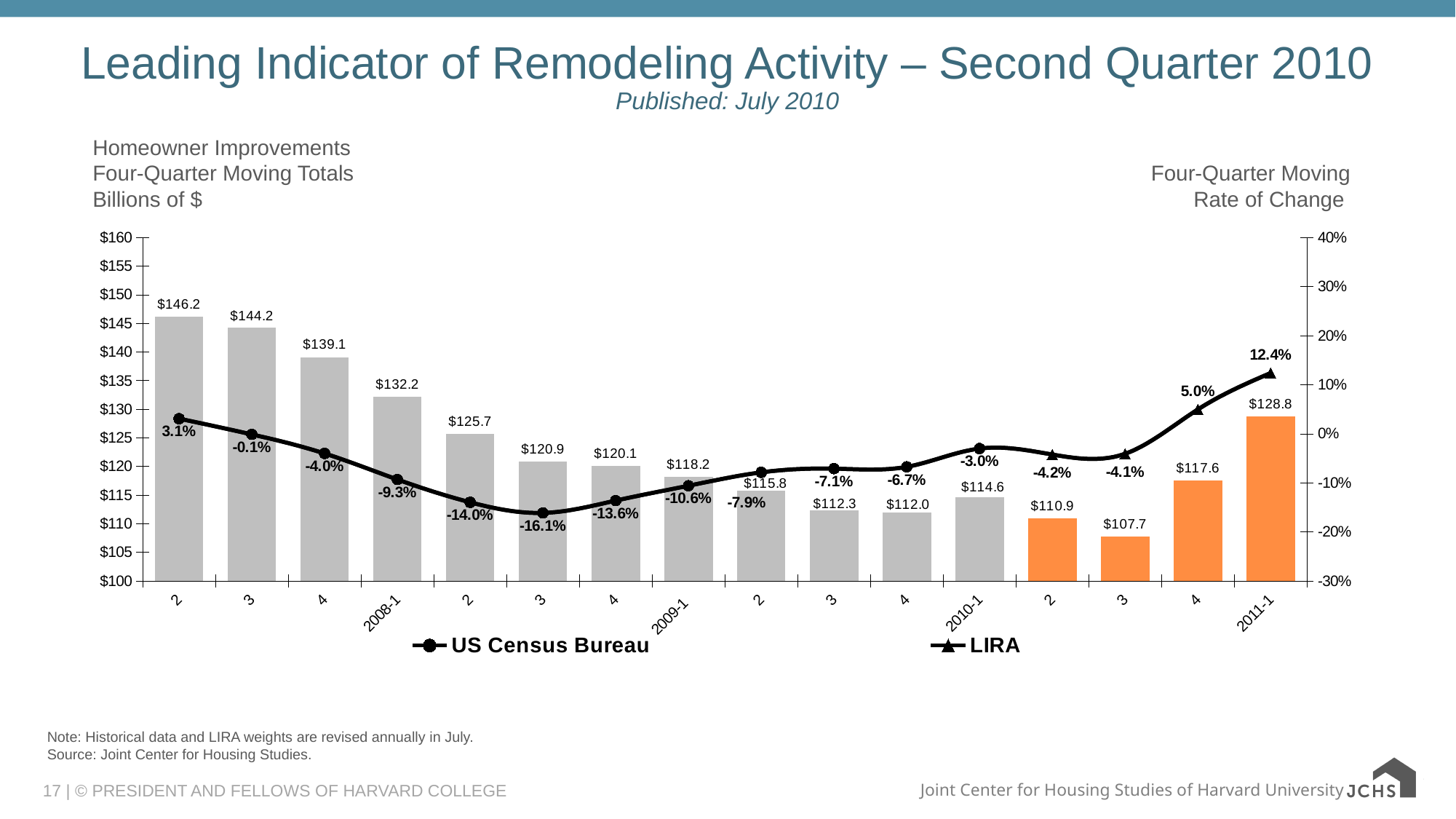
What kind of chart is this? Combined bar and line chart How many series does the legend list? 2 How much larger is the four-quarter moving total for 2011-1 than for 2010-1? $14.2 Which has the larger four-quarter moving total, 2009-1 or 2010-1? 2009-1 How many bars are plotted in the chart? 16 Do the four-quarter moving totals rise or fall from 2008-1 to 2009-1? Fall What is the four-quarter moving total for 2010-1? $114.6 What is the lowest rate of change value shown on the line? -16.1% What is the lowest four-quarter moving total shown by any bar? $107.7 What is the four-quarter moving rate of change shown for 2011-1? 12.4% What is the highest four-quarter moving total shown by any bar? $146.2 What is the four-quarter moving total for 2008-1? $132.2